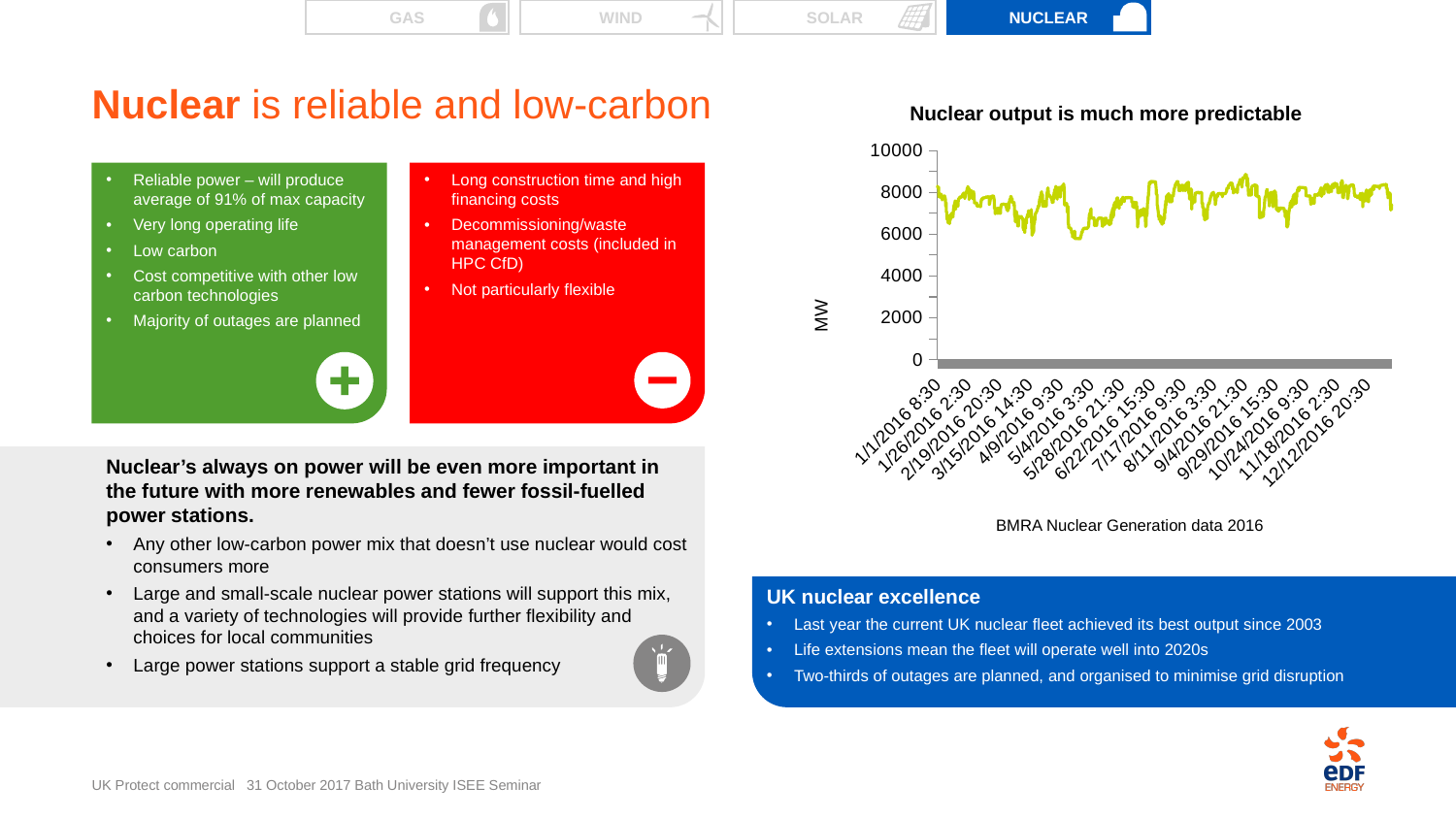
What is the highest value shown on the y-axis of the chart? 10000 Is the value for 1/1/2016 8:30 greater or less than 4000? greater What is the lowest value shown on the y-axis of the chart? 0 What is the title of the chart on the slide? Nuclear output is much more predictable What kind of chart is shown on the slide? line chart Is the value for 7/17/2016 9:30 greater or less than 10000? less Is the value for 12/12/2016 20:30 greater or less than 4000? greater Overall, does the nuclear output line show a strong rising trend, a strong falling trend, or stay roughly level across 2016? roughly level What is the label on the y-axis of the chart? MW What is the first date label shown on the x-axis of the chart? 1/1/2016 8:30